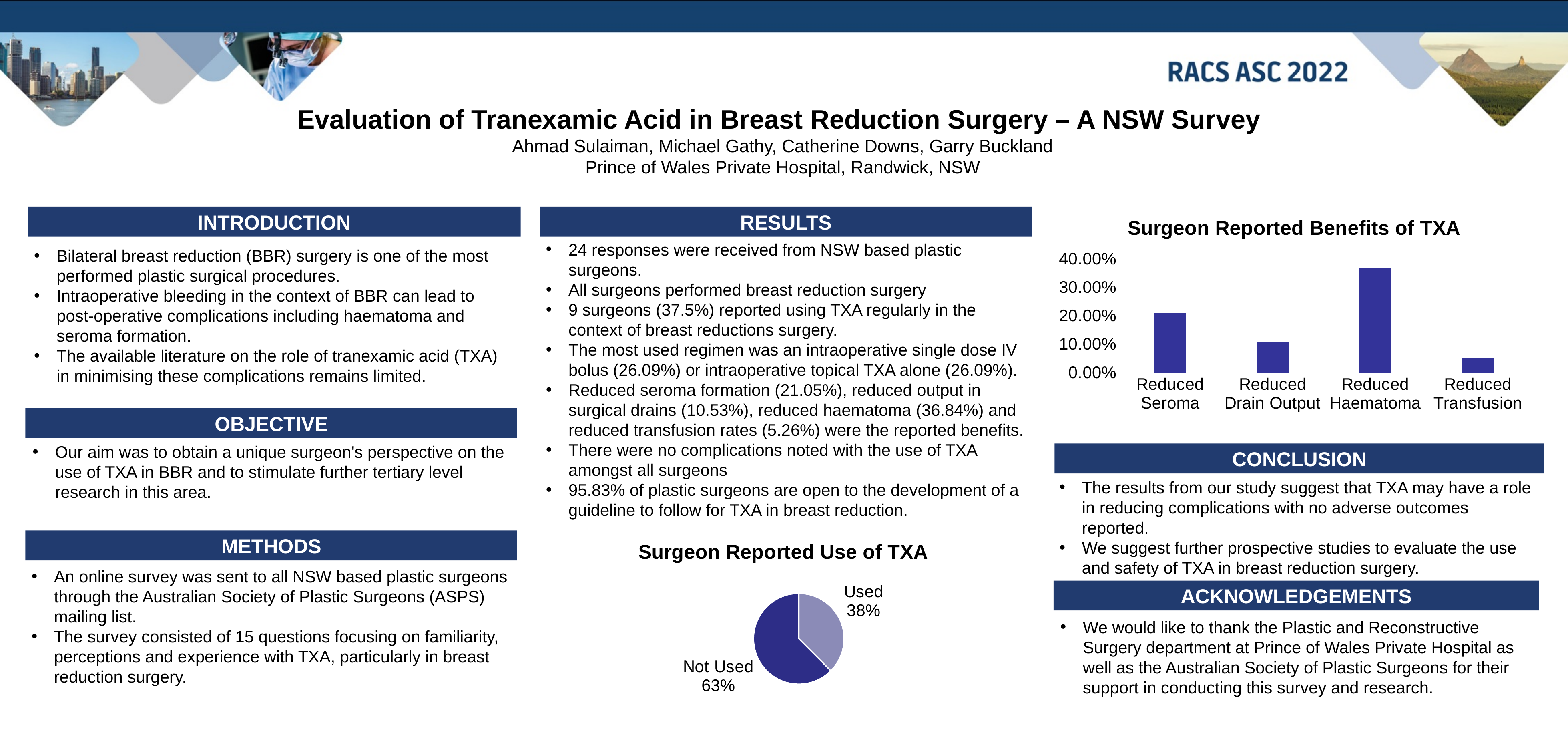
In the "Surgeon Reported Use of TXA" pie chart, what share is labelled "Not Used"? 63% In the "Surgeon Reported Benefits of TXA" chart, which category has the highest value? Reduced Haematoma What kind of chart is "Surgeon Reported Benefits of TXA"? bar chart In the "Surgeon Reported Benefits of TXA" chart, is the value for Reduced Transfusion greater or less than 10.00%? less In the "Surgeon Reported Use of TXA" pie chart, what share is labelled "Used"? 38% In the "Surgeon Reported Benefits of TXA" chart, is the value for Reduced Drain Output greater or less than 20.00%? less In the "Surgeon Reported Benefits of TXA" chart, which is larger: Reduced Seroma or Reduced Drain Output? Reduced Seroma What kind of chart is "Surgeon Reported Use of TXA"? pie chart In the "Surgeon Reported Benefits of TXA" chart, which category has the lowest value? Reduced Transfusion In the "Surgeon Reported Benefits of TXA" chart, is the value for Reduced Haematoma greater or less than 30.00%? greater In the "Surgeon Reported Benefits of TXA" chart, how many categories are shown? 4 In the "Surgeon Reported Use of TXA" pie chart, how many slices are there? 2